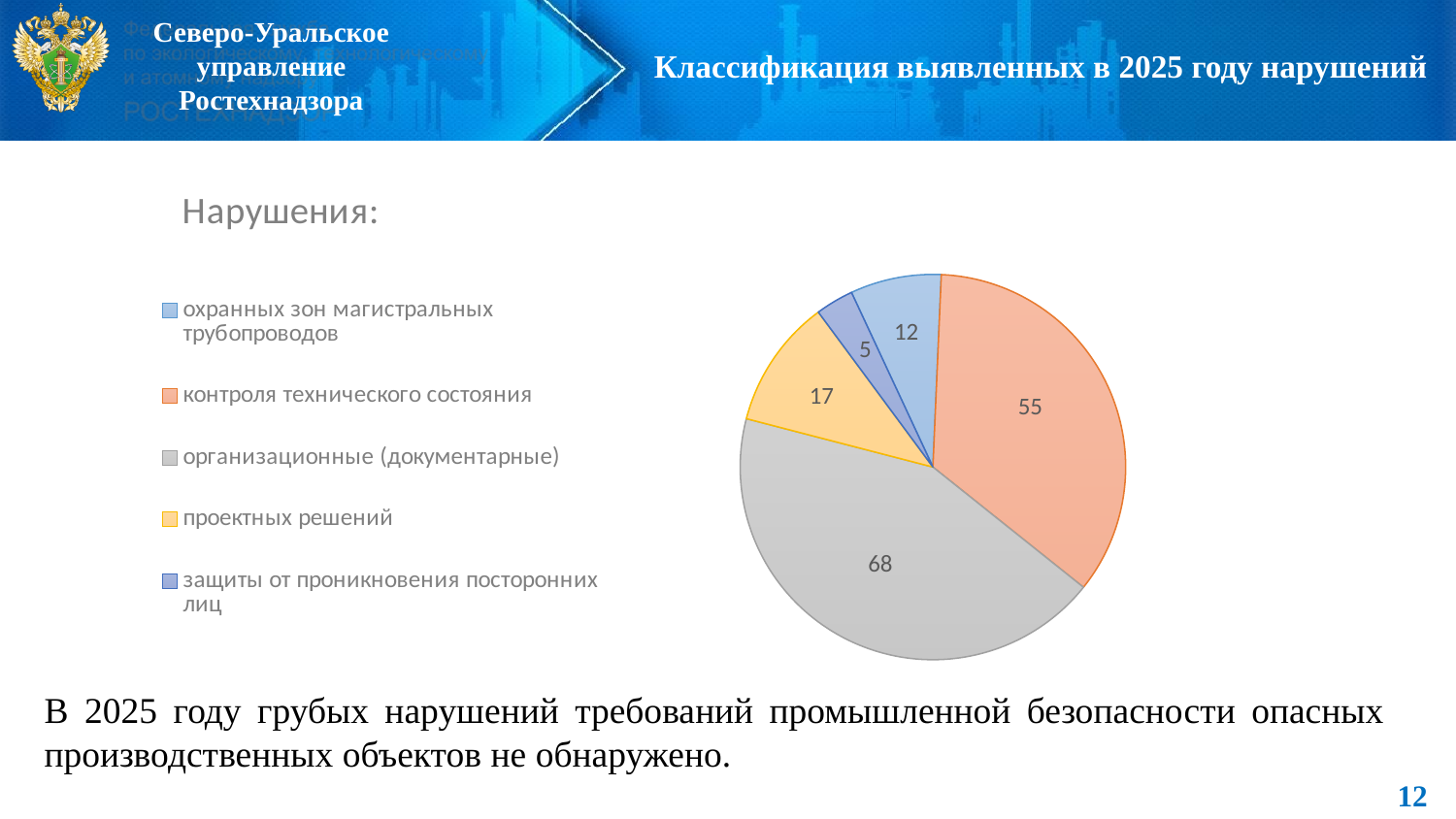
Which is larger: the value for "проектных решений" or the value for "охранных зон магистральных трубопроводов"? проектных решений Which category has the largest slice in the pie chart? организационные (документарные) What is the difference between the values for "организационные (документарные)" and "контроля технического состояния"? 13 What is the value for "организационные (документарные)" in the pie chart? 68 What is the value for "защиты от проникновения посторонних лиц" in the pie chart? 5 What is the title of the chart? Нарушения: How many categories does the pie chart show? 5 Which category has the smallest slice in the pie chart? защиты от проникновения посторонних лиц What is the value for "контроля технического состояния" in the pie chart? 55 What is the value for "проектных решений" in the pie chart? 17 What is the total of all values in the pie chart? 157 What type of chart is shown on the slide? pie chart